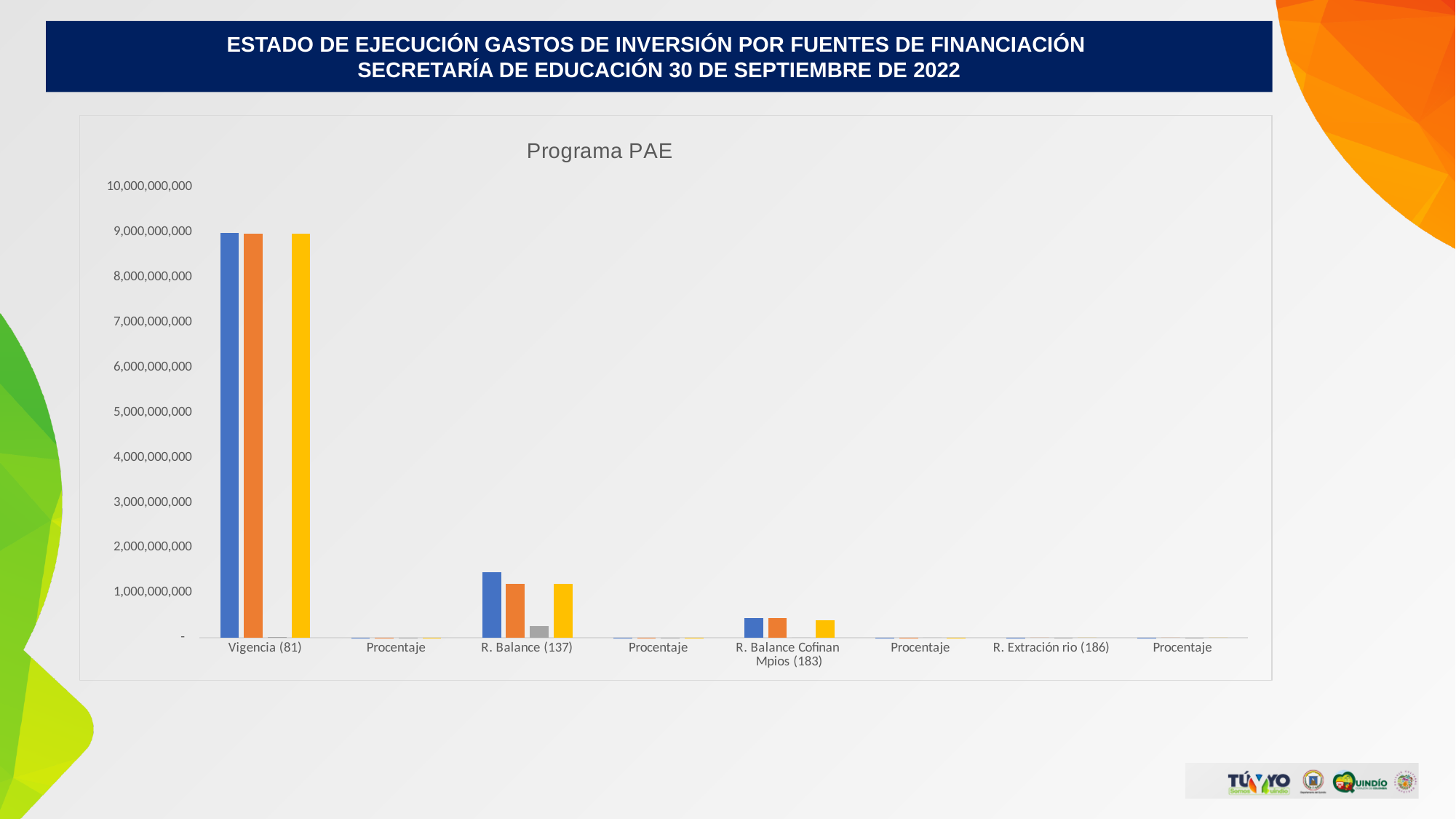
Which has the larger orange bar, R. Balance (137) or R. Balance Cofinan Mpios (183)? R. Balance (137) Is the value of the blue bar for R. Balance Cofinan Mpios (183) greater or less than 1,000,000,000? less Is the value of the blue bar for Vigencia (81) greater or less than 8,000,000,000? greater Is the value of the gray bar for R. Balance (137) greater or less than 1,000,000,000? less What is the title of the chart? Programa PAE What is the highest value shown on the vertical axis of the chart? 10,000,000,000 What kind of chart is shown on the slide? bar chart How many categories are shown on the x axis of the chart? 8 Which has the larger blue bar, Vigencia (81) or R. Balance (137)? Vigencia (81) Which category has the highest bars in the chart? Vigencia (81)